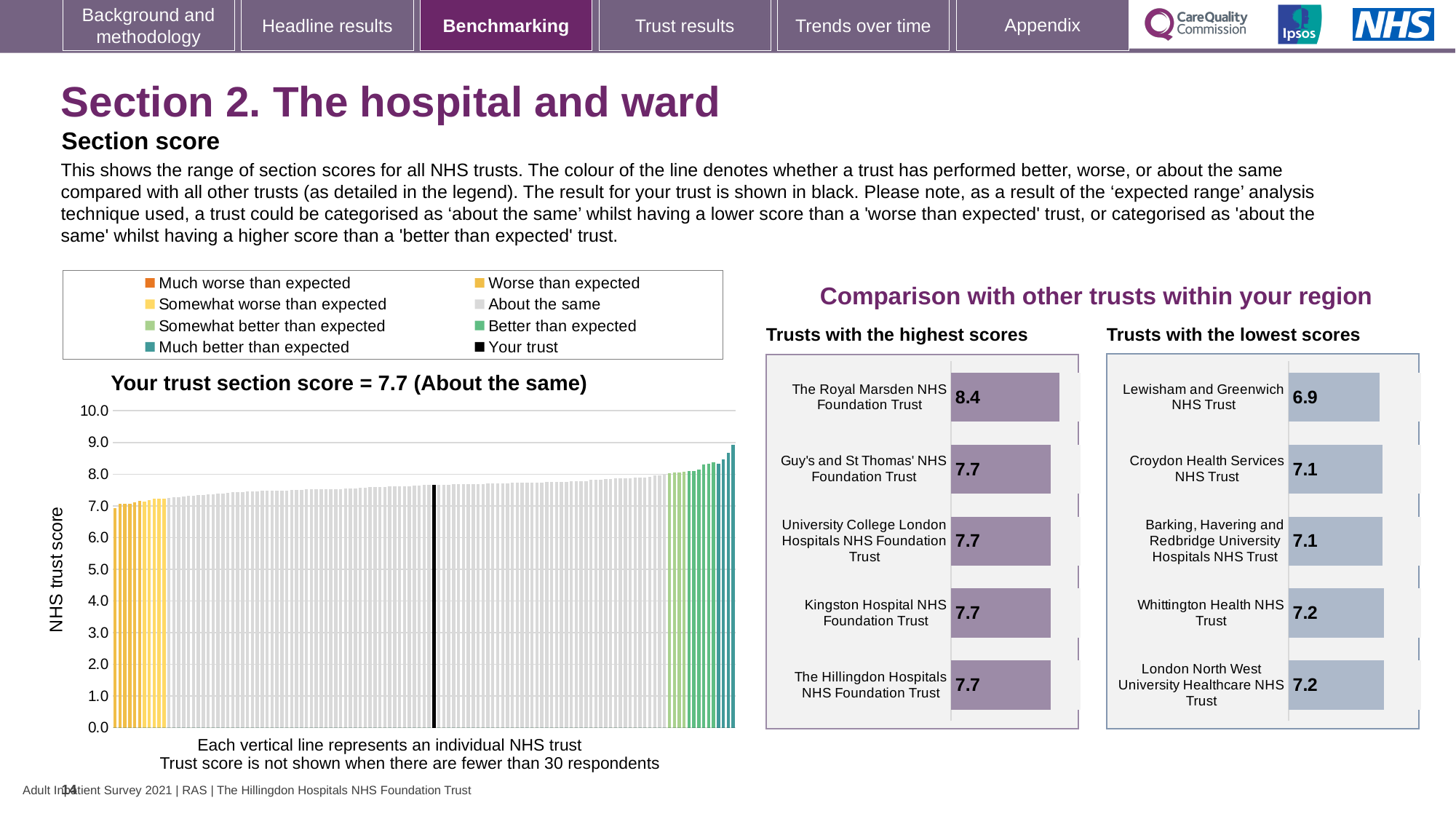
What kind of chart is the 'Your trust section score' chart on the left? bar chart In the 'Trusts with the highest scores' chart, what is the score for The Royal Marsden NHS Foundation Trust? 8.4 In the 'Trusts with the highest scores' chart, what is the difference between the scores of The Royal Marsden NHS Foundation Trust and The Hillingdon Hospitals NHS Foundation Trust? 0.7 In the 'Your trust section score' chart, do the bars rise or fall from left to right? rise In the 'Trusts with the lowest scores' chart, which has the larger score: Croydon Health Services NHS Trust or Whittington Health NHS Trust? Whittington Health NHS Trust What is the y-axis label of the 'Your trust section score' chart? NHS trust score In the 'Your trust section score' chart, what is the section score for your trust? 7.7 In the 'Trusts with the lowest scores' chart, which trust has the lowest score? Lewisham and Greenwich NHS Trust How many entries does the legend above the 'Your trust section score' chart list? 8 In the 'Your trust section score' chart, is the value of the tallest bar greater or less than 8.0? greater In the 'Trusts with the highest scores' chart, which trust has the highest score? The Royal Marsden NHS Foundation Trust In the 'Trusts with the lowest scores' chart, how many trusts are shown? 5